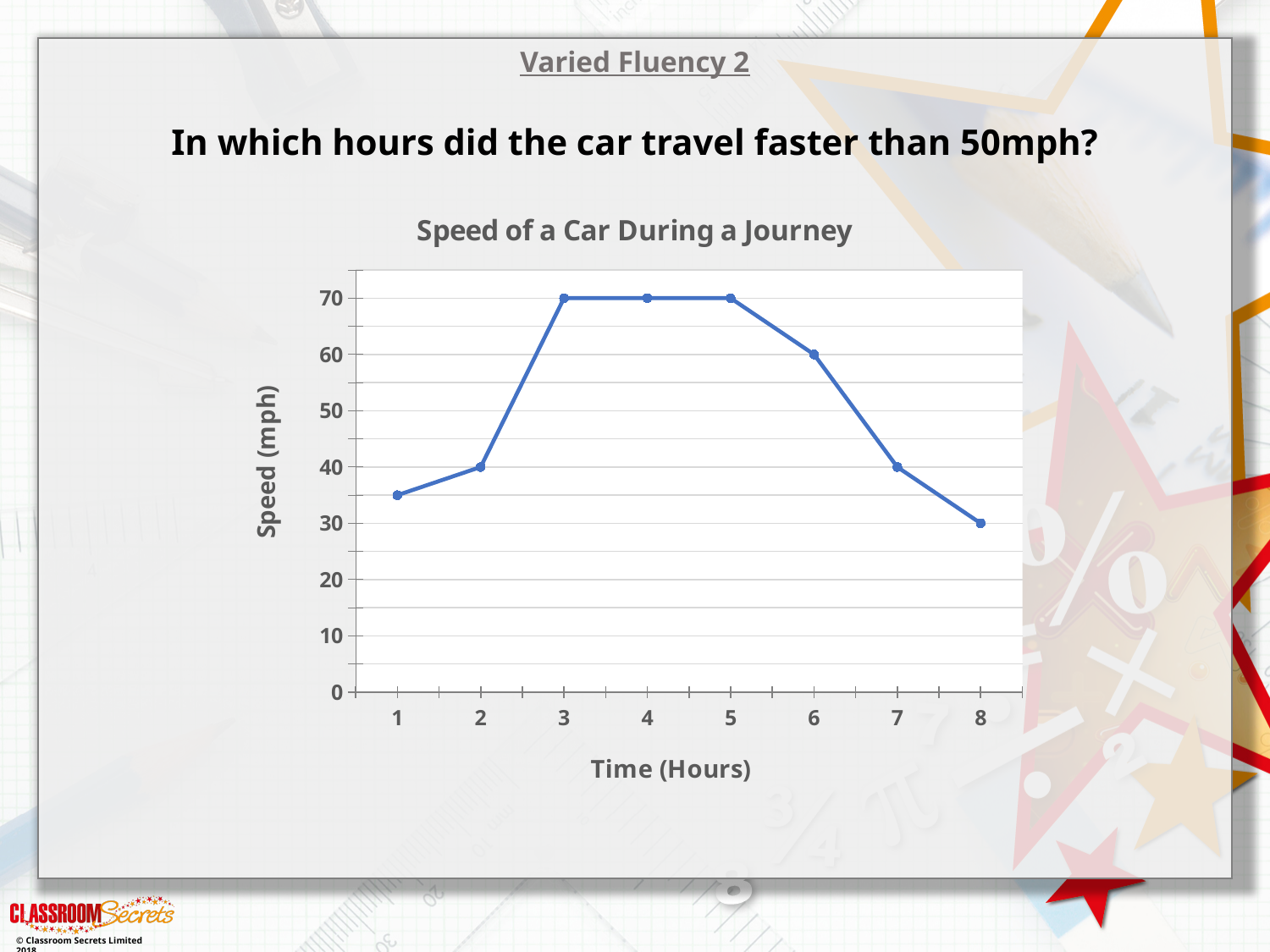
What was the speed of the car at hour 6? 60 How many data points are plotted on the chart? 8 Does the speed rise or fall from hour 5 to hour 8? fall What is the label on the vertical axis of the chart? Speed (mph) What type of chart is shown on the slide? line chart What is the title of the chart? Speed of a Car During a Journey What is the difference between the speed at hour 6 and the speed at hour 7? 20 Is the speed at hour 1 greater or less than 40? less What was the speed of the car at hour 3? 70 What was the speed of the car at hour 8? 30 What was the speed of the car at hour 2? 40 At which hour was the car's speed lowest? 8